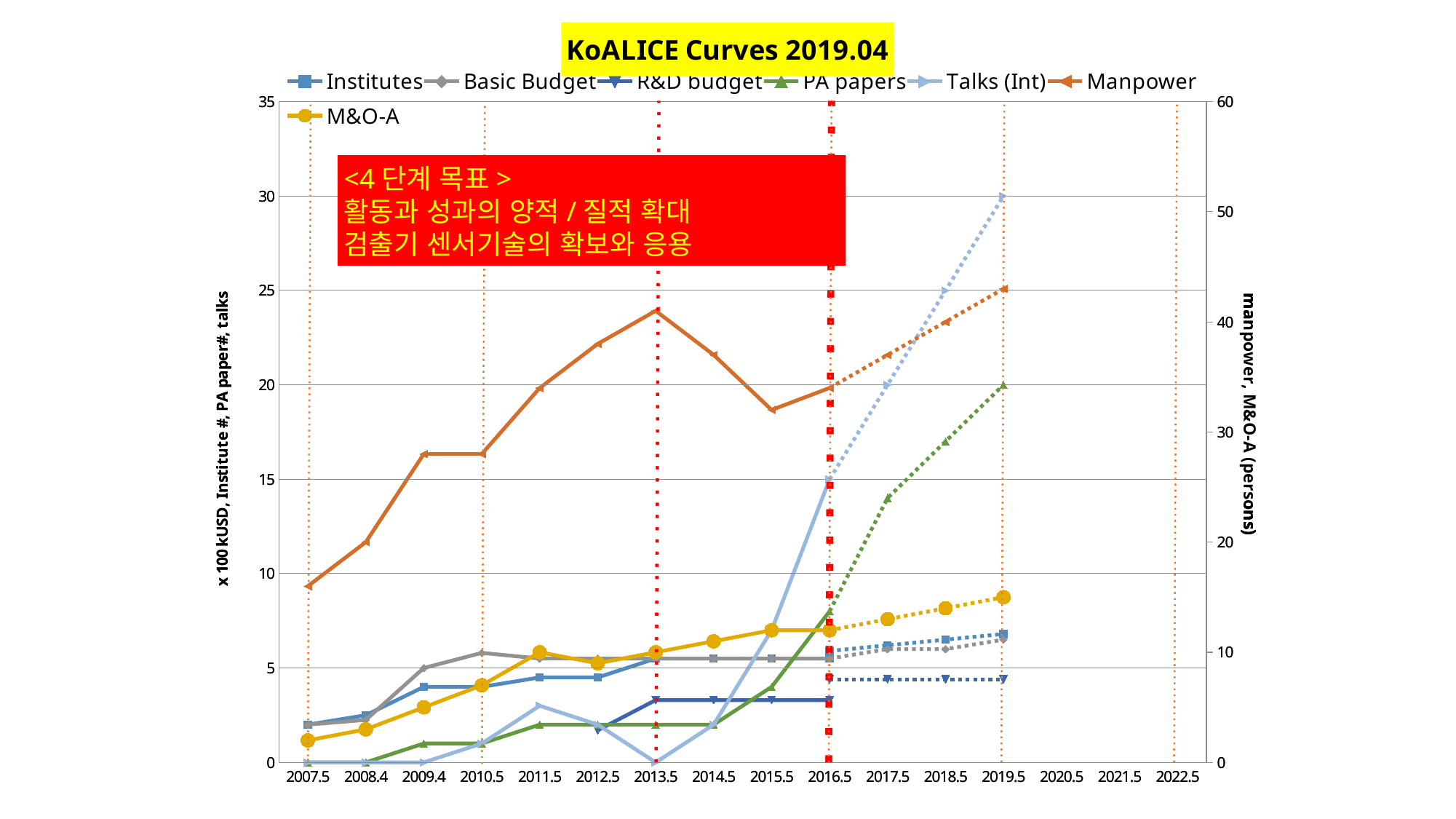
At 2019.5, which is higher: PA papers or M&O-A? PA papers How many series does the legend list? 7 What is the value of Talks (Int) at 2013.5? 0 What kind of chart is shown on the slide? line chart What is the value of PA papers at 2019.5? 20 What is the value of Talks (Int) at 2019.5? 30 Is the value for Talks (Int) at 2018.5 greater or less than 20? greater Which series reaches the highest point on the chart at 2019.5? Talks (Int) What is the difference between Talks (Int) and PA papers at 2019.5? 10 Is the value for Institutes at 2007.5 greater or less than 5? less Does the Talks (Int) series rise or fall from 2016.5 to 2019.5? rise How many categories are shown on the x axis? 16